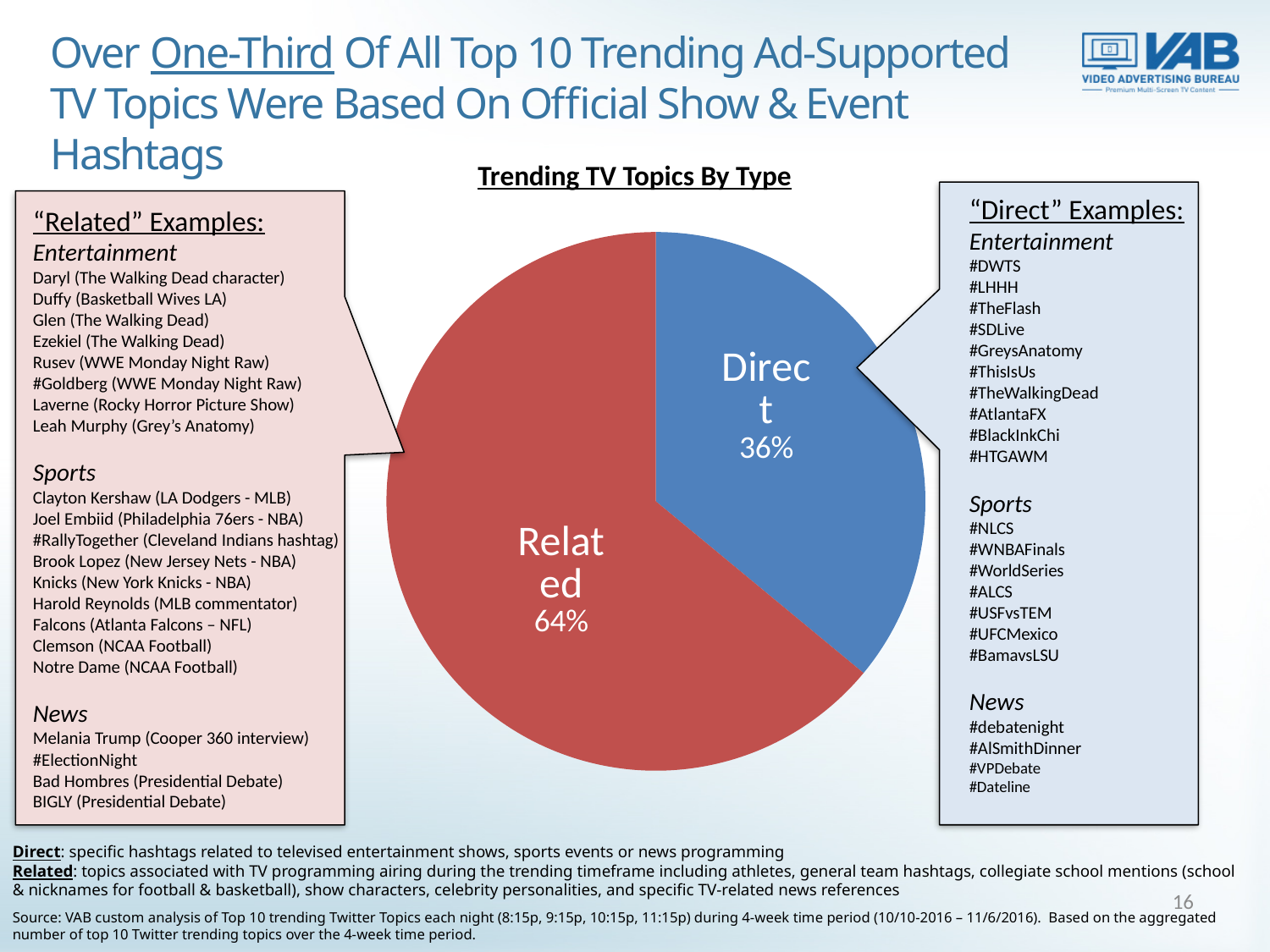
How many slices does the pie chart have? 2 What share of trending TV topics is labelled "Related"? 64% Which slice of the pie is the largest? Related What share of trending TV topics is labelled "Direct"? 36% What is the title of the chart? Trending TV Topics By Type Which is larger, the Direct slice or the Related slice? Related What is the difference in percentage points between the Related and Direct slices? 28 Which slice of the pie is the smallest? Direct What kind of chart is shown on the slide? pie chart What colour is the Direct slice of the pie? blue What is the combined share of the Direct and Related slices? 100%